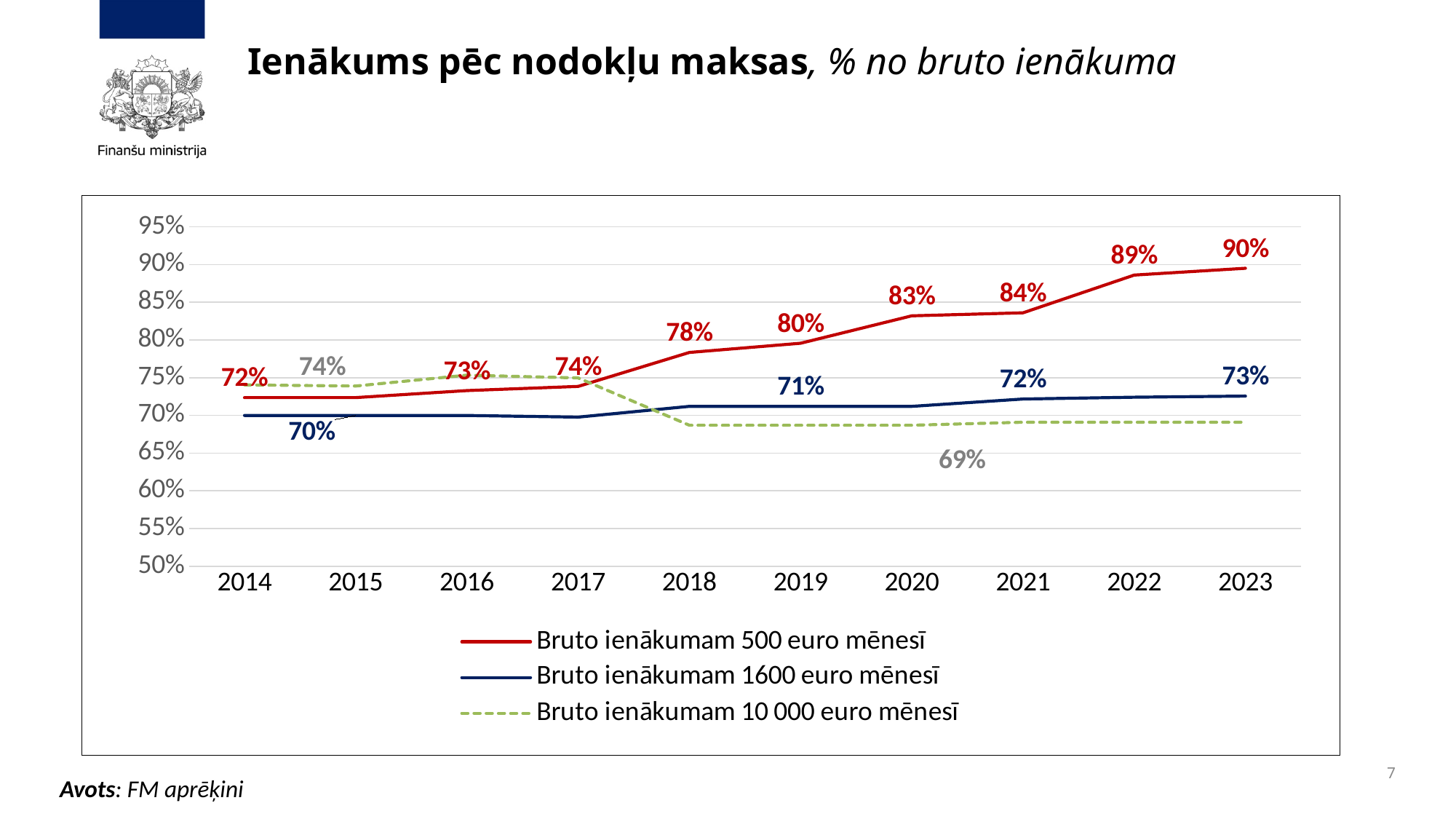
By how many percentage points did the 'Bruto ienākumam 500 euro mēnesī' series change from 2014 to 2023? 18 percentage points What kind of chart is shown on the slide? Line chart What is the value for the 'Bruto ienākumam 1600 euro mēnesī' series in 2023? 73% How many years are shown on the x axis of the chart? 10 What is the value for the 'Bruto ienākumam 1600 euro mēnesī' series in 2014? 70% In 2023, which series has the higher value: 'Bruto ienākumam 500 euro mēnesī' or 'Bruto ienākumam 1600 euro mēnesī'? Bruto ienākumam 500 euro mēnesī Is the value for 'Bruto ienākumam 1600 euro mēnesī' in 2017 greater or less than 75%? less How many series does the legend list? 3 What is the value for the 'Bruto ienākumam 500 euro mēnesī' series in 2018? 78% In which year does the 'Bruto ienākumam 500 euro mēnesī' series reach its highest value? 2023 Is the value for 'Bruto ienākumam 10 000 euro mēnesī' in 2014 greater or less than 70%? greater What is the value for the 'Bruto ienākumam 500 euro mēnesī' series in 2023? 90%